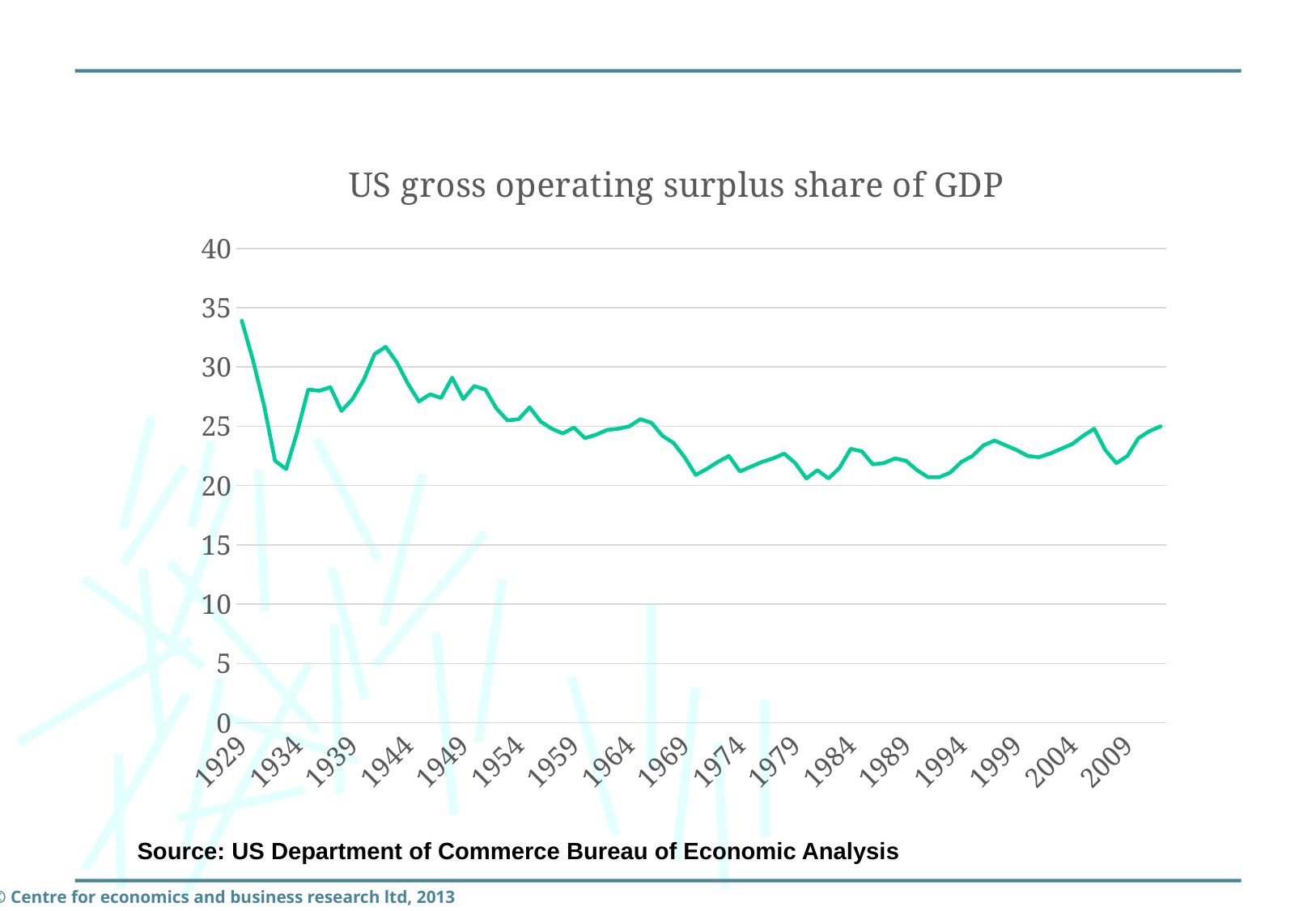
What is the title of the chart? US gross operating surplus share of GDP What kind of chart is shown on the slide? line chart Is the value for 1979 greater or less than 25? less Is the value for 2009 greater or less than 25? less Overall, does the line rise or fall from 1929 to the end of the series? fall How many year labels are shown on the x axis? 17 Which is larger, the value for 1944 or the value for 1984? 1944 Is the value for 1929 greater or less than 30? greater Which is larger, the value for 1929 or the value for 2009? 1929 Which year on the x axis has the highest value? 1929